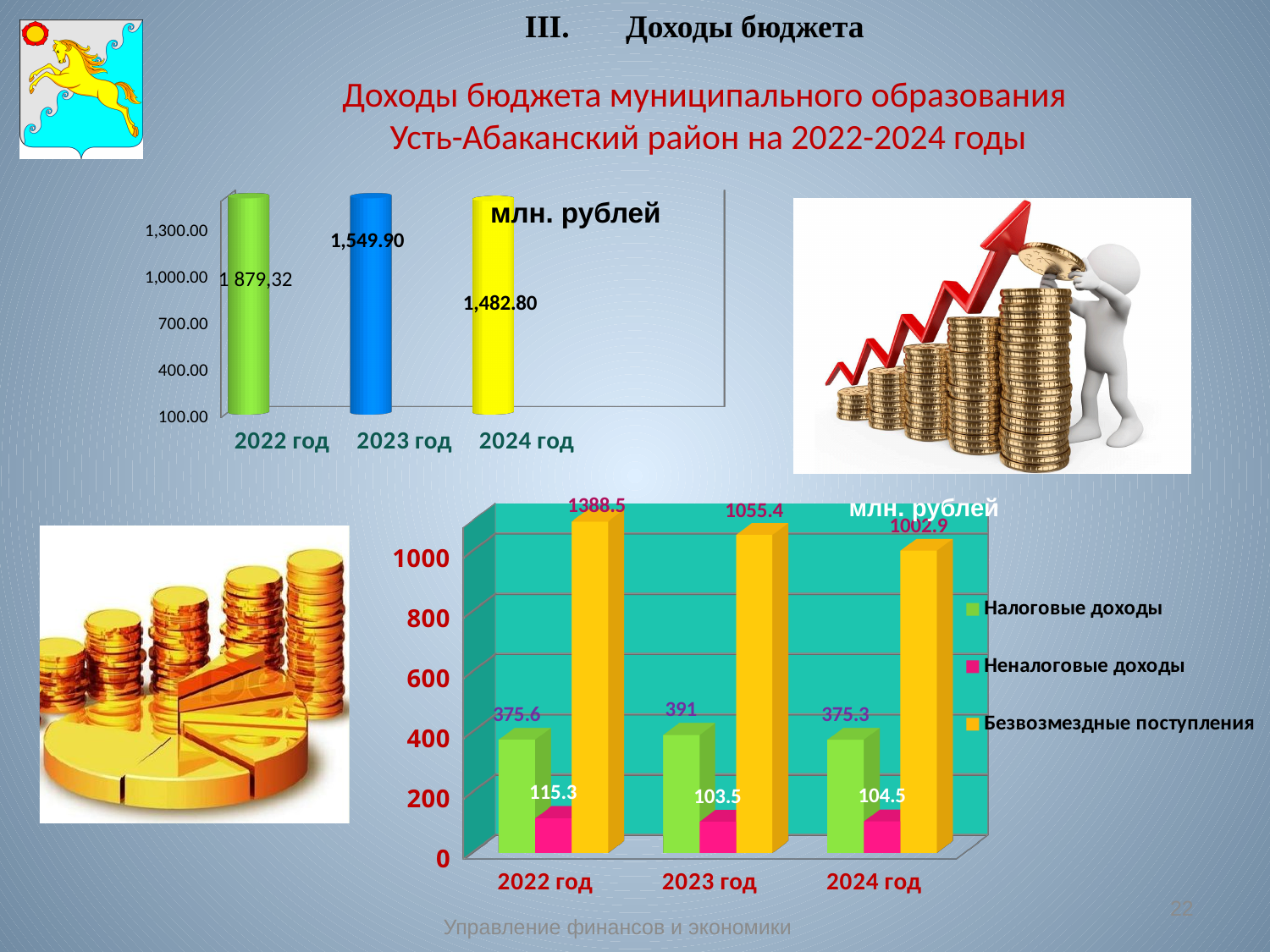
In the bottom chart, what is the value of Неналоговые доходы for 2024 год? 104.5 In the top chart, what is the value for 2023 год? 1,549.90 In the top chart, how many years are shown? 3 In the bottom chart, what is the value of Безвозмездные поступления for 2022 год? 1388.5 In the bottom chart, how many series does the legend list? 3 In the bottom chart, what is the difference between Безвозмездные поступления in 2022 год and 2023 год? 333.1 In the bottom chart, which year has the lowest value of Неналоговые доходы? 2023 год What type of chart is the bottom chart? Bar chart In the bottom chart, what is the value of Налоговые доходы for 2023 год? 391 In the bottom chart, which year has the highest value of Безвозмездные поступления? 2022 год In the top chart, what unit is stated for the values? млн. рублей In the top chart, what is the value for 2024 год? 1,482.80